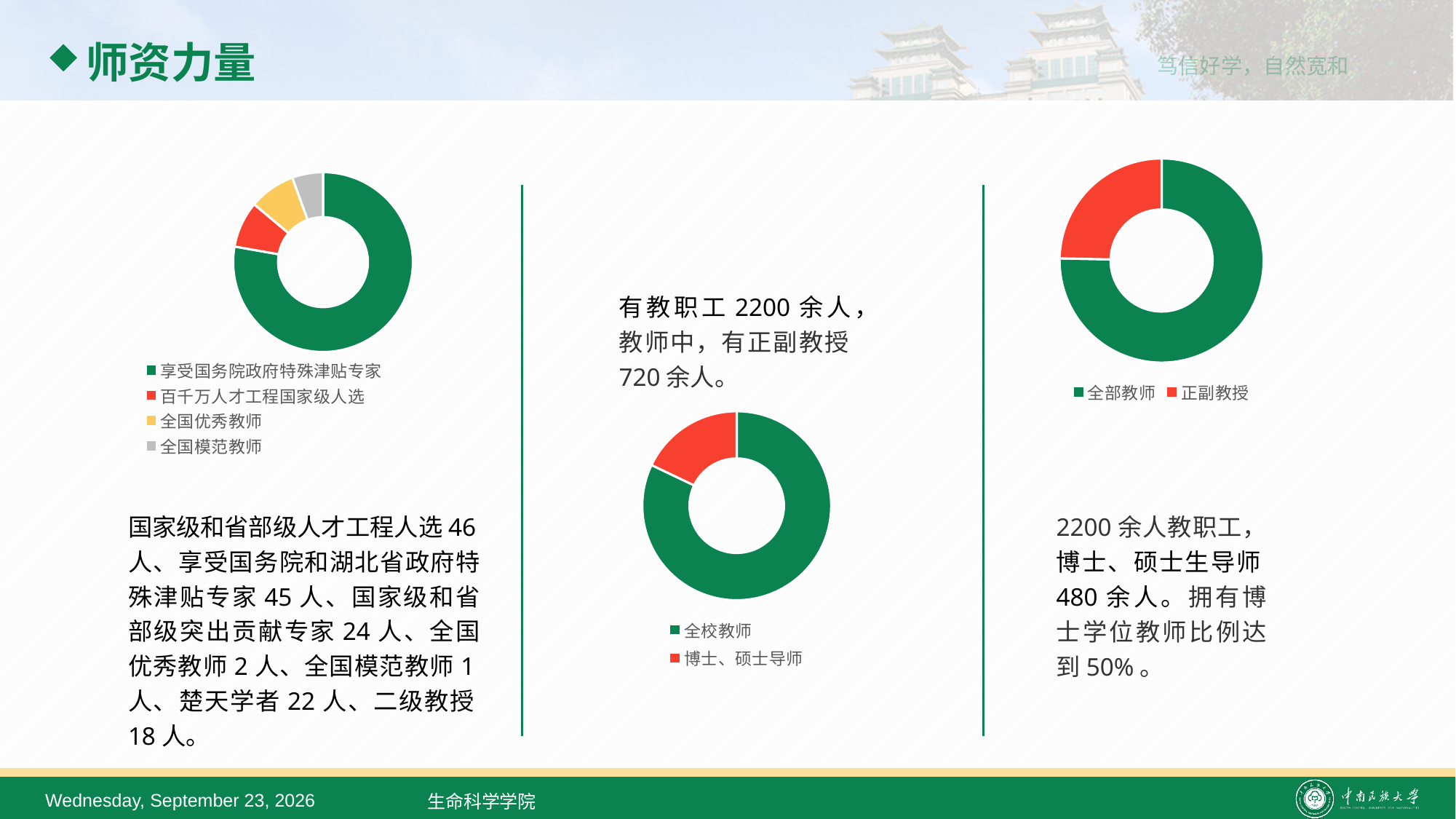
In the chart on the left of the slide, which category has the largest slice? 享受国务院政府特殊津贴专家 In the chart in the middle of the slide, which is larger, 全校教师 or 博士、硕士导师? 全校教师 In the chart on the left of the slide, which category has the smallest slice? 全国模范教师 What kind of chart is the chart on the left of the slide? doughnut chart In the chart on the left of the slide, how many categories does the legend list? 4 In the chart on the left of the slide, what colour is the slice for 全国优秀教师? yellow In the chart in the middle of the slide, what are the two legend entries? 全校教师, 博士、硕士导师 In the chart on the right of the slide, how many categories does the legend list? 2 What kind of chart is the chart on the right of the slide? doughnut chart In the chart in the middle of the slide, how many categories are shown? 2 In the chart in the middle of the slide, which category has the larger slice? 全校教师 In the chart on the right of the slide, which category has the smaller slice? 正副教授